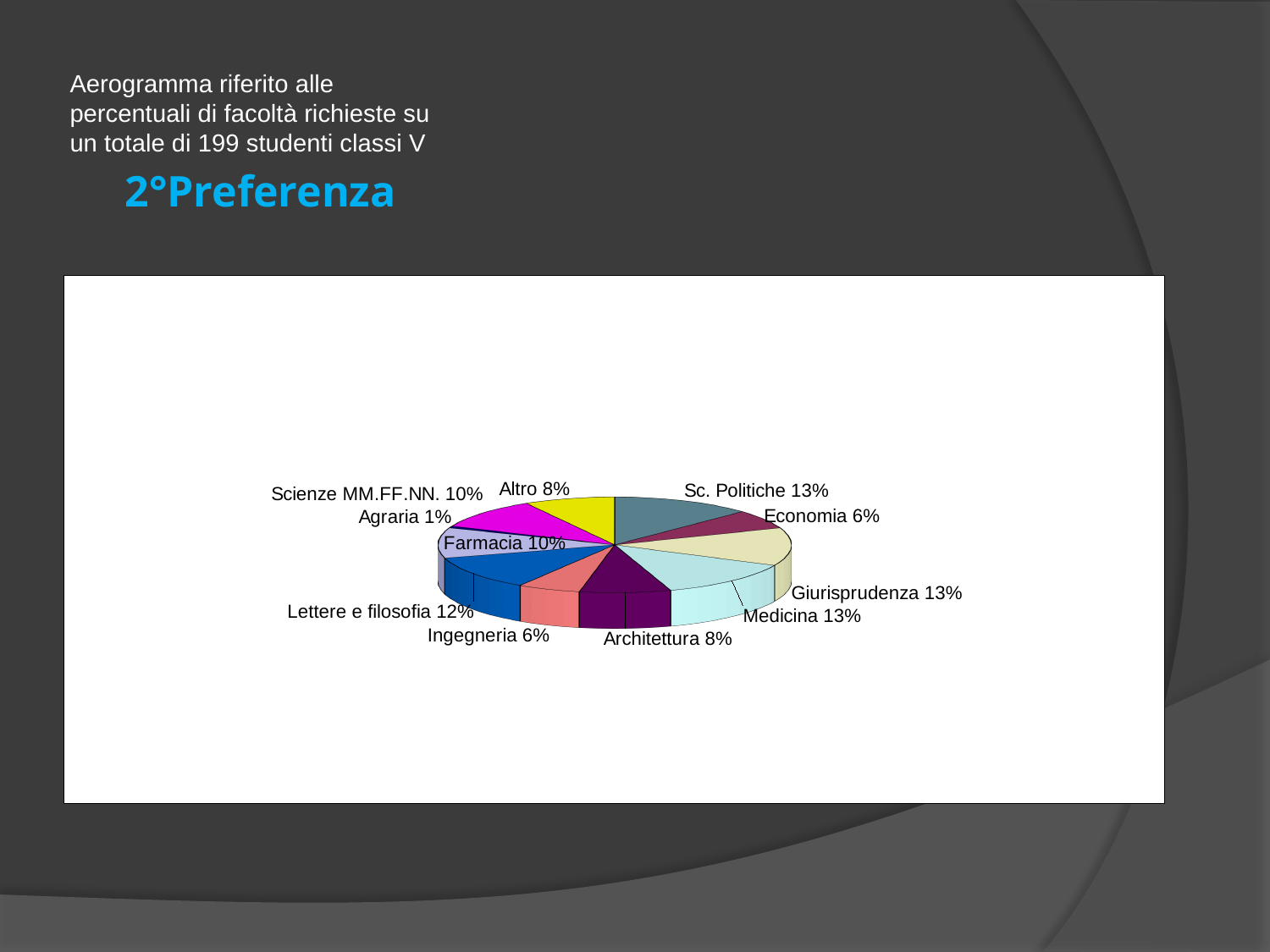
What percentage is shown for Farmacia? 10% How many slices does the pie chart have? 11 What percentage is shown for Lettere e filosofia? 12% What is the heading shown in blue above the chart? 2°Preferenza What kind of chart is shown on the slide? pie chart Which is larger, the slice for Scienze MM.FF.NN. or the slice for Giurisprudenza? Giurisprudenza What percentage is shown for Medicina? 13% Which is larger, the slice for Ingegneria or the slice for Altro? Altro What percentage is shown for Economia? 6% What is the difference in percentage points between Sc. Politiche and Architettura? 5 Which faculty has the smallest slice of the pie? Agraria What is the combined percentage of Agraria and Farmacia? 11%